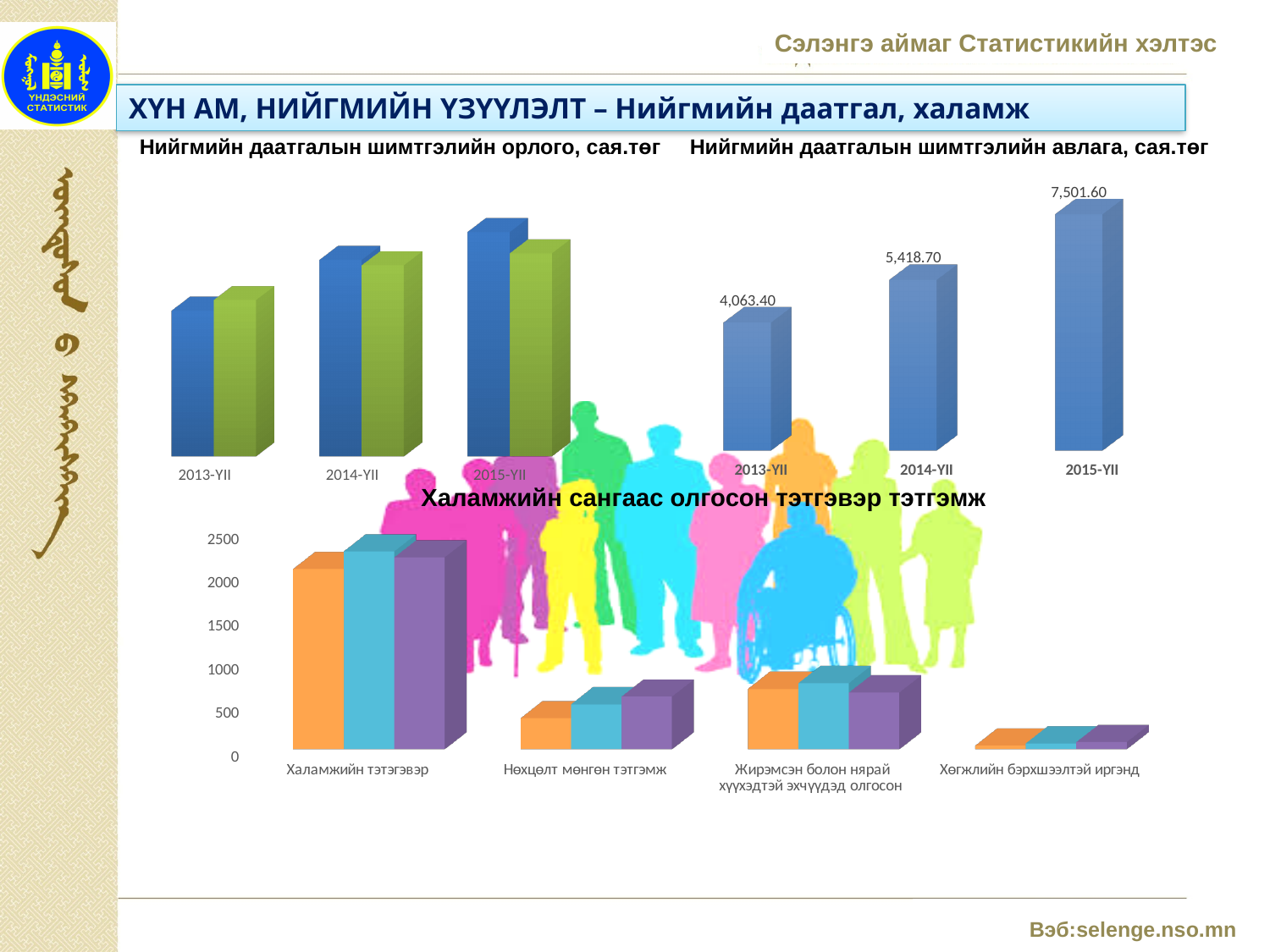
In the chart 'Нийгмийн даатгалын шимтгэлийн авлага, сая.төг', what is the difference between the 2015-YII and 2013-YII values? 3,438.20 In the chart 'Нийгмийн даатгалын шимтгэлийн орлого, сая.төг', do the bars rise or fall from 2013-YII to 2015-YII? rise How many categories are shown on the x axis of the chart 'Халамжийн сангаас олгосон тэтгэвэр тэтгэмж'? 4 In the chart 'Нийгмийн даатгалын шимтгэлийн авлага, сая.төг', what is the value for 2013-YII? 4,063.40 What kind of chart is 'Нийгмийн даатгалын шимтгэлийн орлого, сая.төг'? bar chart In the chart 'Нийгмийн даатгалын шимтгэлийн авлага, сая.төг', what is the value for 2015-YII? 7,501.60 In the chart 'Халамжийн сангаас олгосон тэтгэвэр тэтгэмж', which category has the lowest bars? Хөгжлийн бэрхшээлтэй иргэнд In the chart 'Халамжийн сангаас олгосон тэтгэвэр тэтгэмж', which category has the highest bars? Халамжийн тэтэгэвэр In the chart 'Нийгмийн даатгалын шимтгэлийн авлага, сая.төг', do the values rise or fall from 2013-YII to 2015-YII? rise In the chart 'Нийгмийн даатгалын шимтгэлийн авлага, сая.төг', what is the difference between the 2014-YII and 2013-YII values? 1,355.30 In the chart 'Нийгмийн даатгалын шимтгэлийн авлага, сая.төг', which year has the highest value? 2015-YII